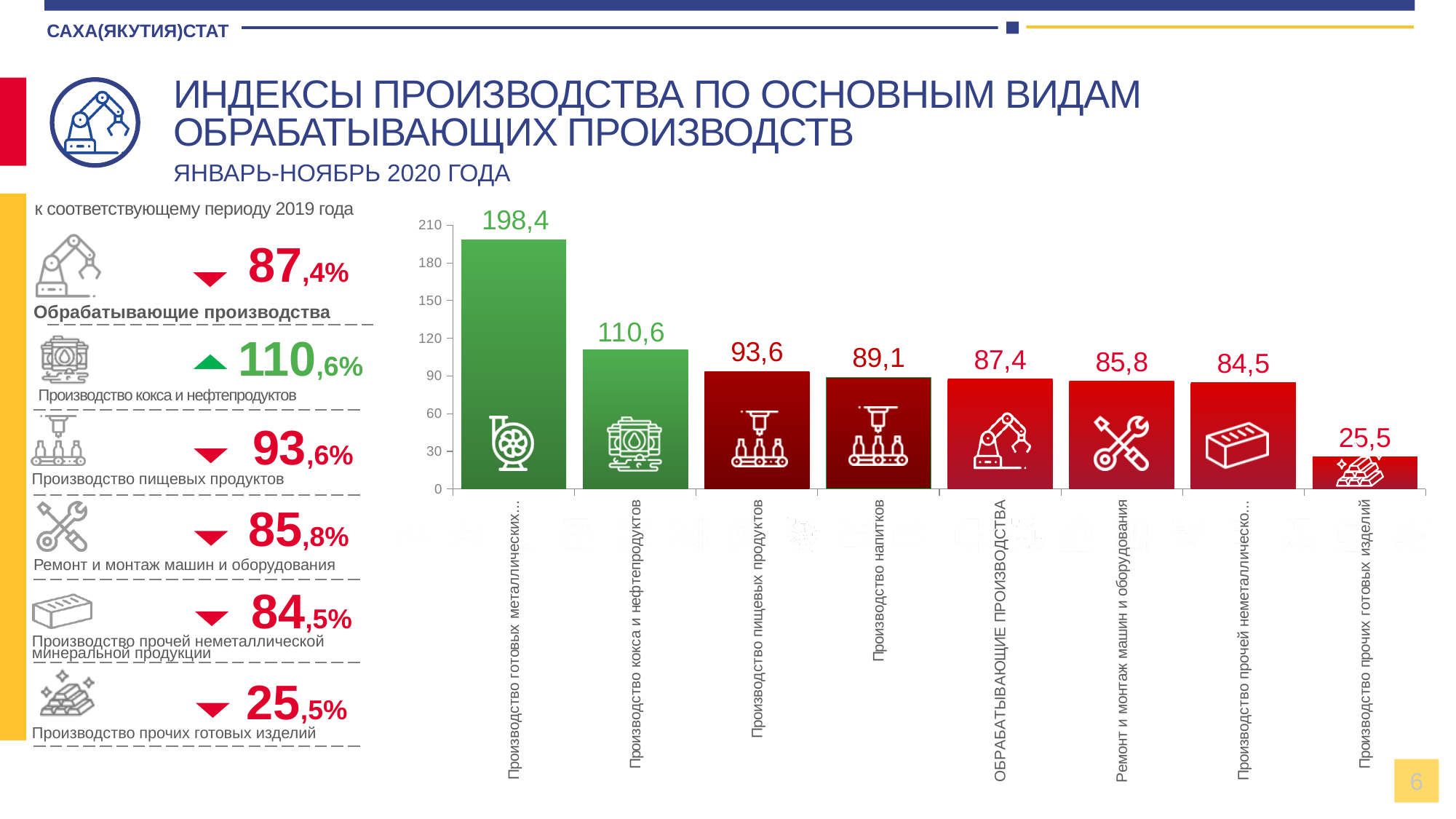
What is the value for Производство кокса и нефтепродуктов? 110,6 Which category has the highest value in the chart? Производство готовых металлических... Which is larger: the value for Производство пищевых продуктов or the value for Производство напитков? Производство пищевых продуктов Do the bar values rise or fall from left to right along the x axis? fall What type of chart is shown on the slide? bar chart Which category has the lowest value in the chart? Производство прочих готовых изделий What is the value for Производство пищевых продуктов? 93,6 What is the value for Производство прочих готовых изделий? 25,5 What is the value for ОБРАБАТЫВАЮЩИЕ ПРОИЗВОДСТВА? 87,4 What is the value for Производство напитков? 89,1 How many bars are plotted in the chart? 8 What is the difference between the values for Ремонт и монтаж машин и оборудования and Производство прочих готовых изделий? 60,3